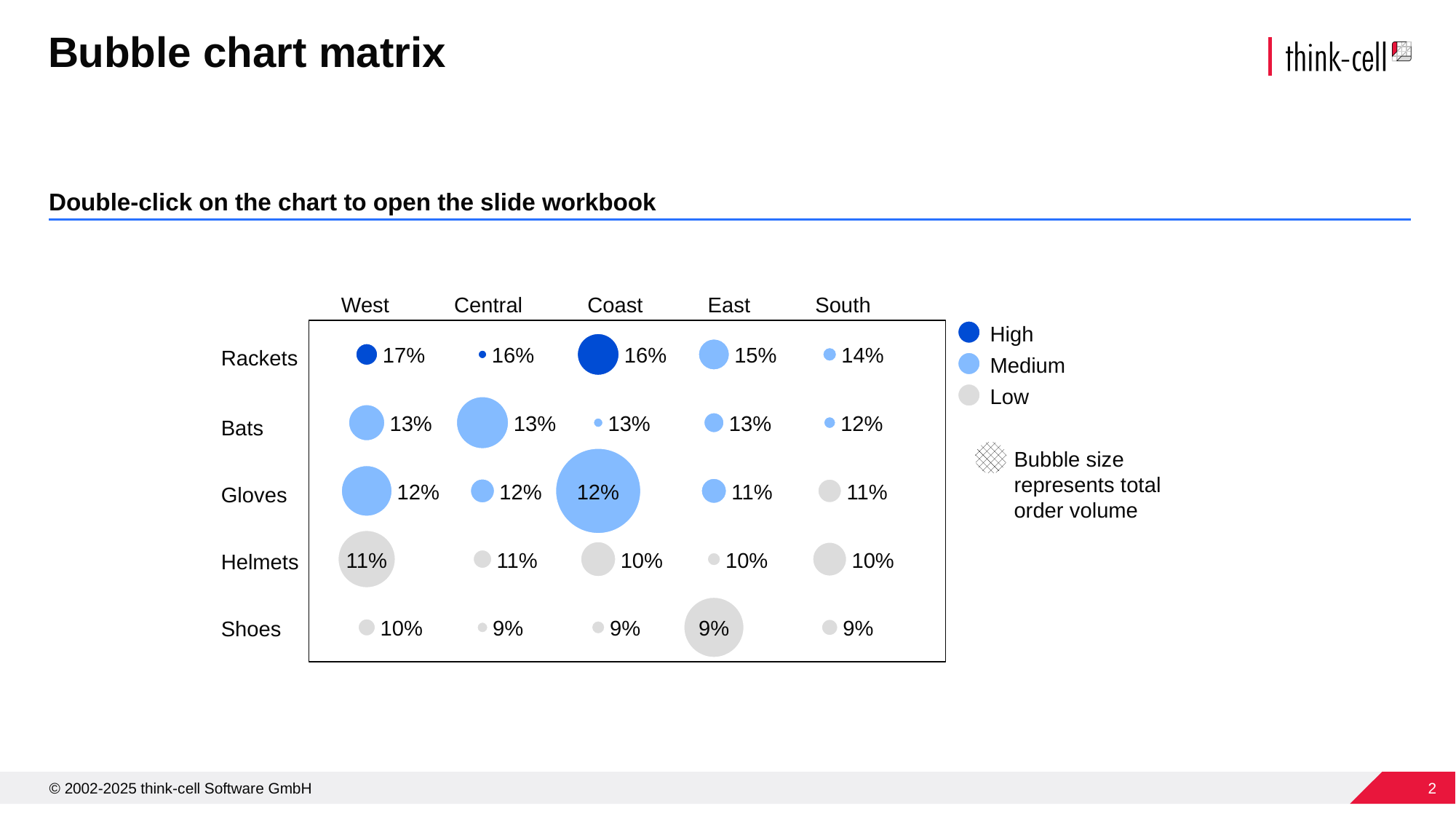
Which is larger: the Bats value in West or the Bats value in South? Bats in West What is the difference between the Rackets value in West and the Rackets value in South? 3% What is the value for Rackets in the West column? 17% What is the value for Helmets in the South column? 10% How many region columns are shown in the matrix? 5 What is the value for Gloves in the Coast column? 12% How many product rows are shown in the matrix? 5 Which product row has the lowest value in the Central column? Shoes What is the value for Shoes in the East column? 9% Which product row has the highest value in the West column? Rackets How many categories does the legend list? 3 What does the bubble size represent according to the legend? Total order volume